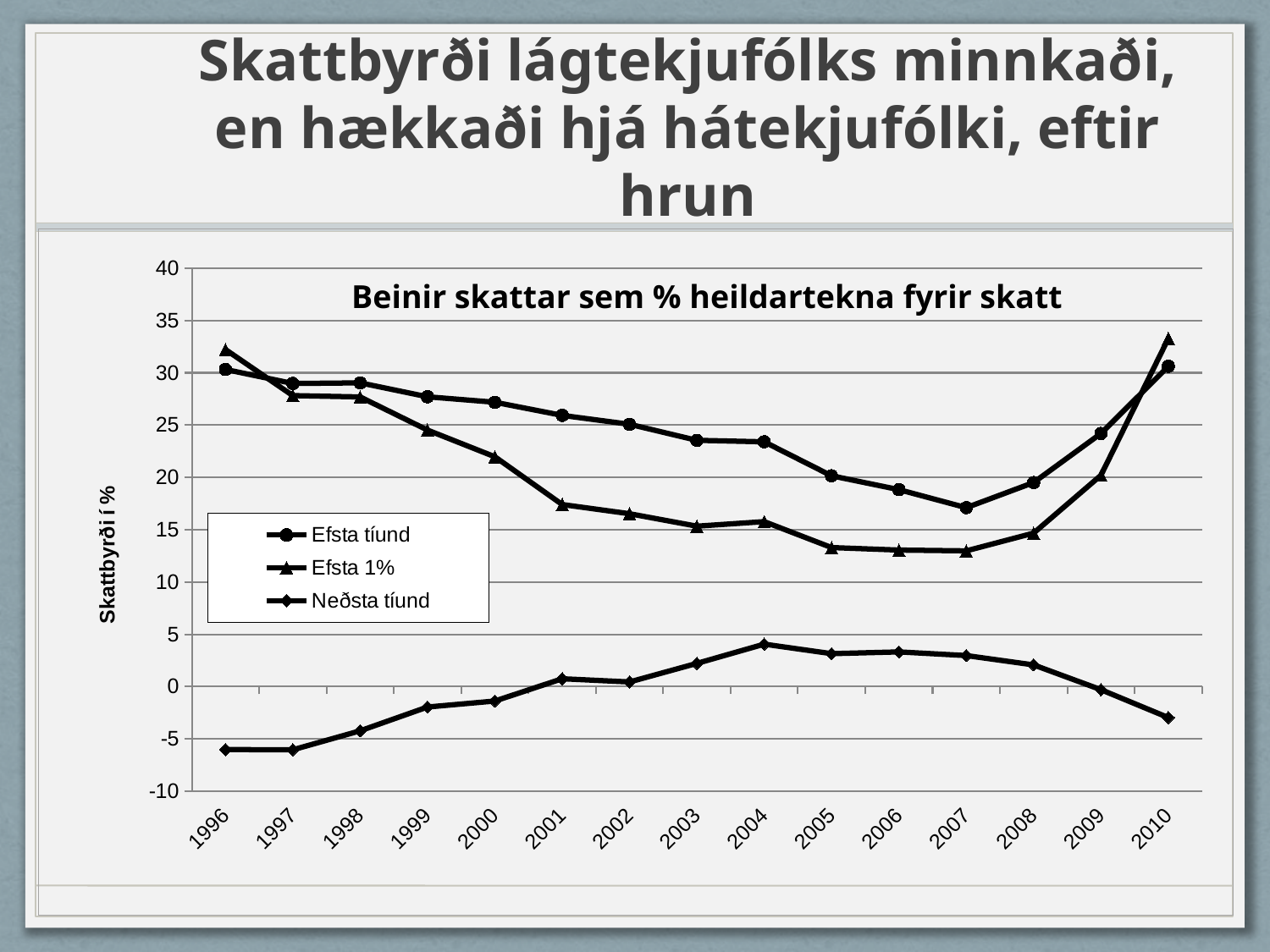
What kind of chart is shown on the slide? line chart How many series does the chart legend list? 3 How many years are plotted along the x axis? 15 In which year does the Neðsta tíund series reach its highest value? 2004 Is the value for Efsta 1% in 2010 greater or less than 30? greater Is the value for Efsta tíund in 2007 greater or less than 15? greater What is the label of the vertical axis? Skattbyrði í % What is the title printed inside the chart area? Beinir skattar sem % heildartekna fyrir skatt Is the value for Neðsta tíund in 1996 greater or less than -5? less In 1996, which series has the higher value, Efsta 1% or Efsta tíund? Efsta 1% In which year does the Efsta tíund series reach its lowest value? 2007